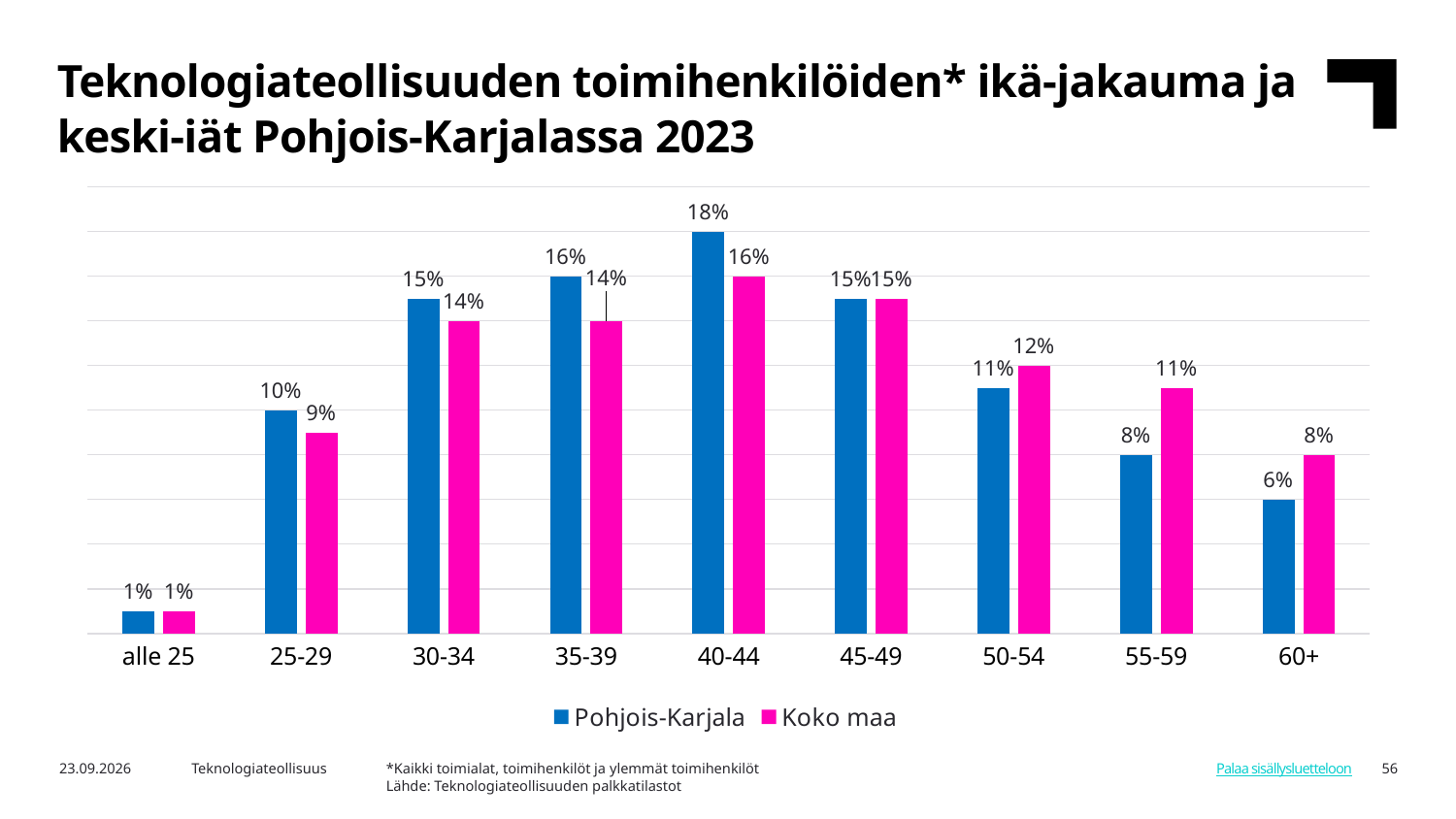
Which age group has the lowest value for Koko maa? alle 25 Which series is shown in pink? Koko maa What is the difference between Pohjois-Karjala and Koko maa in the 35-39 age group? 2 percentage points Which is larger in the 55-59 age group, Pohjois-Karjala or Koko maa? Koko maa What is the value for Pohjois-Karjala in the 25-29 age group? 10% What is the value for Pohjois-Karjala in the 40-44 age group? 18% What kind of chart is shown on the slide? Bar chart What is the value for Koko maa in the 55-59 age group? 11% Which age group has the highest value for Pohjois-Karjala? 40-44 How many age groups are shown on the x axis? 9 Which is larger in the 30-34 age group, Pohjois-Karjala or Koko maa? Pohjois-Karjala How many series does the legend list? 2